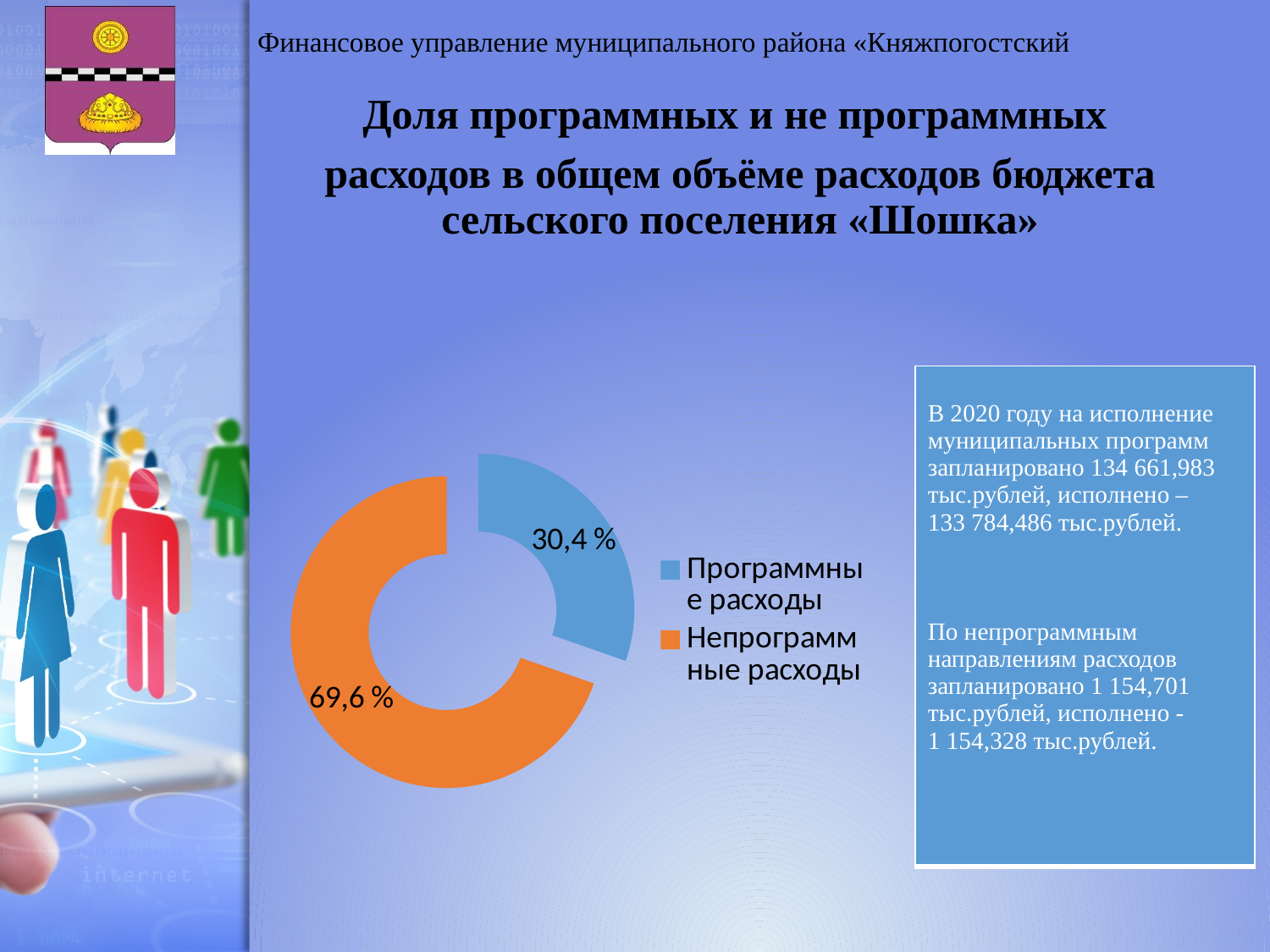
What share of the doughnut chart is labelled for Программные расходы? 30,4 % What colour represents Программные расходы in the doughnut chart? blue Which is larger in the doughnut chart: Программные расходы or Непрограммные расходы? Непрограммные расходы What is the total of the two shares shown in the doughnut chart? 100 % What colour represents Непрограммные расходы in the doughnut chart? orange What kind of chart is shown on the slide? doughnut chart What share of the doughnut chart is labelled for Непрограммные расходы? 69,6 % How many categories does the doughnut chart show? 2 What is the difference in percentage points between the Непрограммные расходы and Программные расходы shares? 39,2 How many entries does the legend of the doughnut chart list? 2 Which category has the largest share in the doughnut chart? Непрограммные расходы Which category has the smallest share in the doughnut chart? Программные расходы